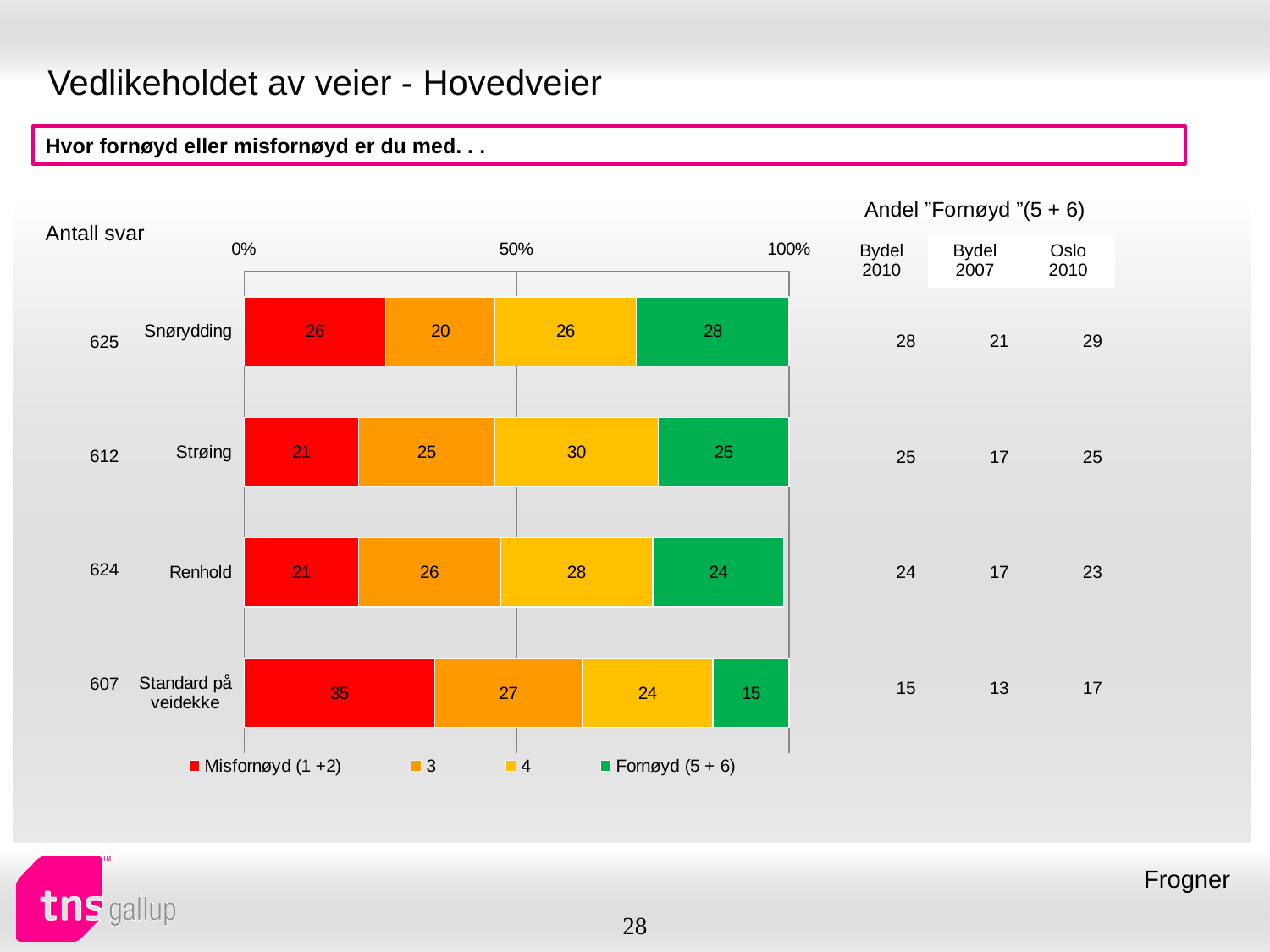
How many categories are plotted in the chart? 4 Which category has the highest Misfornøyd (1 +2) value? Standard på veidekke What kind of chart is shown on the slide? stacked bar chart Which is larger: the Misfornøyd (1 +2) value for Snørydding or for Strøing? Snørydding What is the value of series 3 for Renhold? 26 Which series is shown in green in the chart? Fornøyd (5 + 6) What is the Fornøyd (5 + 6) value for Snørydding? 28 What is the difference between the Fornøyd (5 + 6) values for Snørydding and Standard på veidekke? 13 What is the Misfornøyd (1 +2) value for Standard på veidekke? 35 What is the value of series 4 for Strøing? 30 Which category has the lowest Fornøyd (5 + 6) value? Standard på veidekke How many series does the legend list? 4